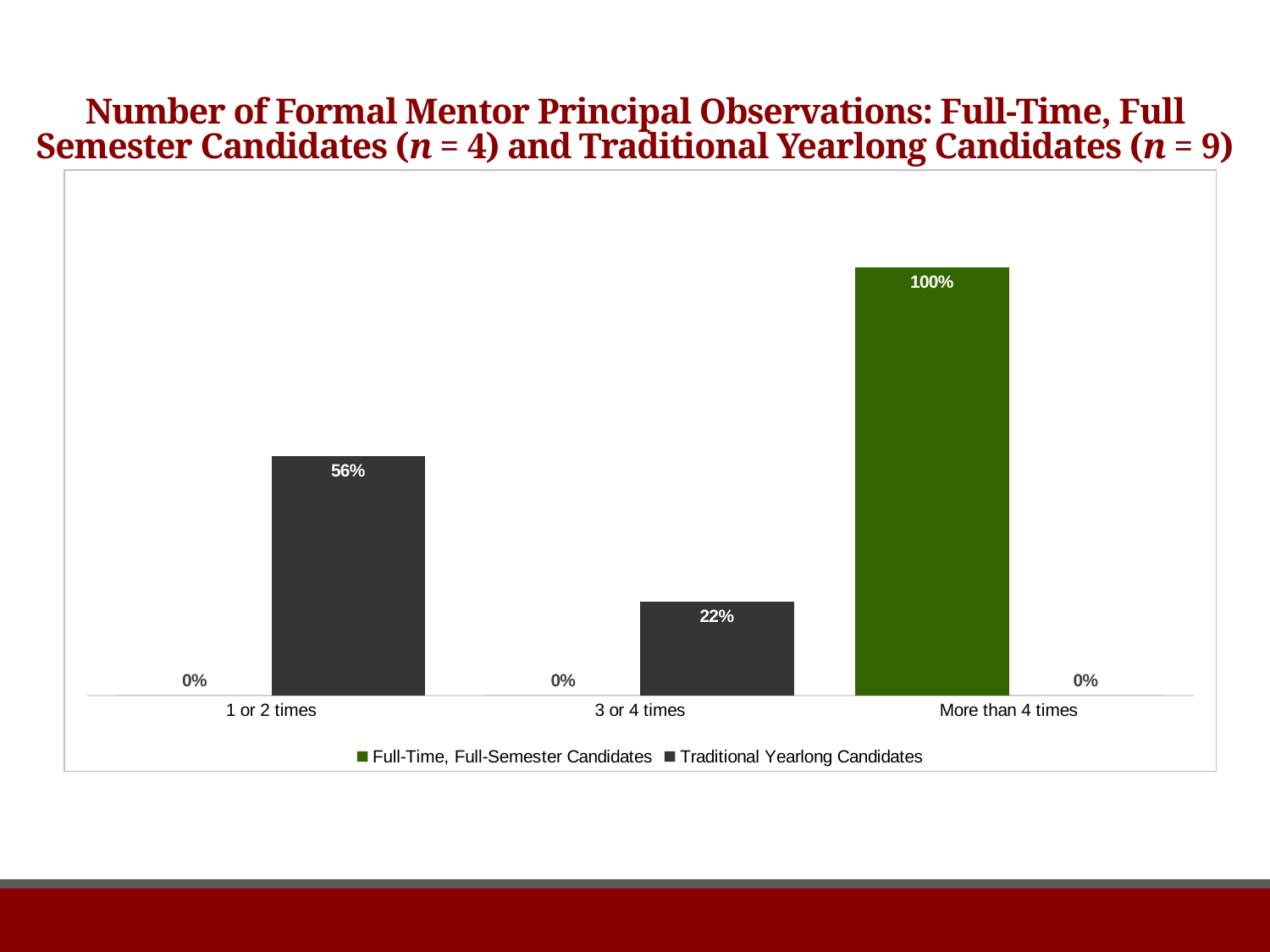
What kind of chart is shown on the slide? Bar chart What percentage of Traditional Yearlong Candidates had 1 or 2 formal mentor principal observations? 56% What percentage of Full-Time, Full-Semester Candidates had more than 4 formal mentor principal observations? 100% What percentage of Full-Time, Full-Semester Candidates had 1 or 2 observations? 0% Which colour represents Full-Time, Full-Semester Candidates in the legend? Green How many series does the legend list? 2 How many categories are shown on the x axis? 3 Which category has the highest value for Traditional Yearlong Candidates? 1 or 2 times What is the difference between the Traditional Yearlong Candidates values for 1 or 2 times and 3 or 4 times? 34% What percentage of Traditional Yearlong Candidates had more than 4 observations? 0% Which is larger for the 3 or 4 times category: Full-Time, Full-Semester Candidates or Traditional Yearlong Candidates? Traditional Yearlong Candidates What percentage of Traditional Yearlong Candidates had 3 or 4 observations? 22%